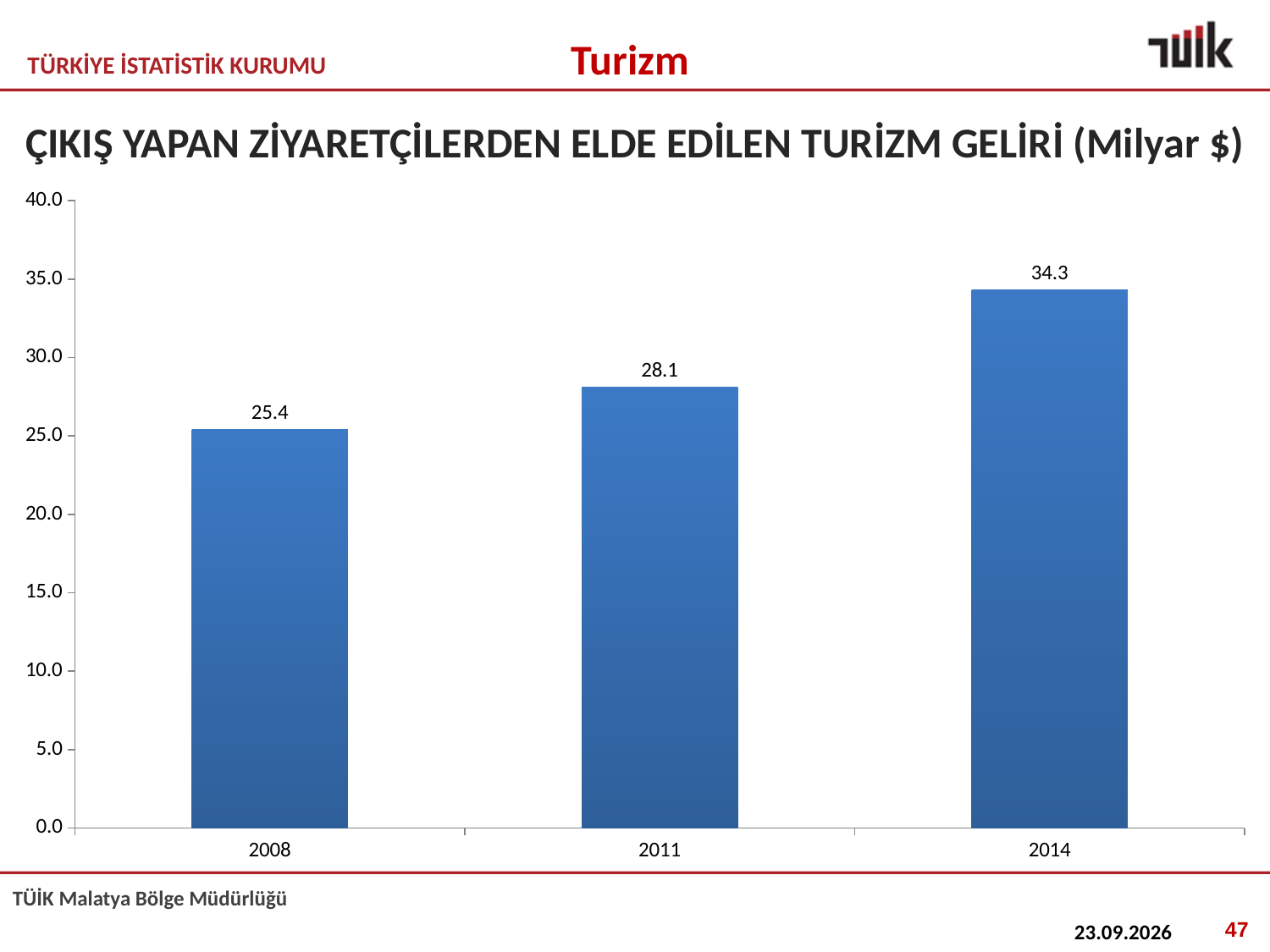
What is the tourism revenue value shown for 2011? 28.1 Do the values rise or fall from 2008 to 2014? rise What is the difference between the values for 2011 and 2008? 2.7 How many years are shown on the chart? 3 What is the tourism revenue value shown for 2014? 34.3 Which is larger, the value for 2011 or the value for 2014? 2014 Which year has the lowest tourism revenue? 2008 Which year has the highest tourism revenue? 2014 What is the difference between the values for 2014 and 2008? 8.9 What kind of chart is shown on the slide? bar chart What is the tourism revenue value shown for 2008? 25.4 Is the value for 2011 greater or less than 30.0? less